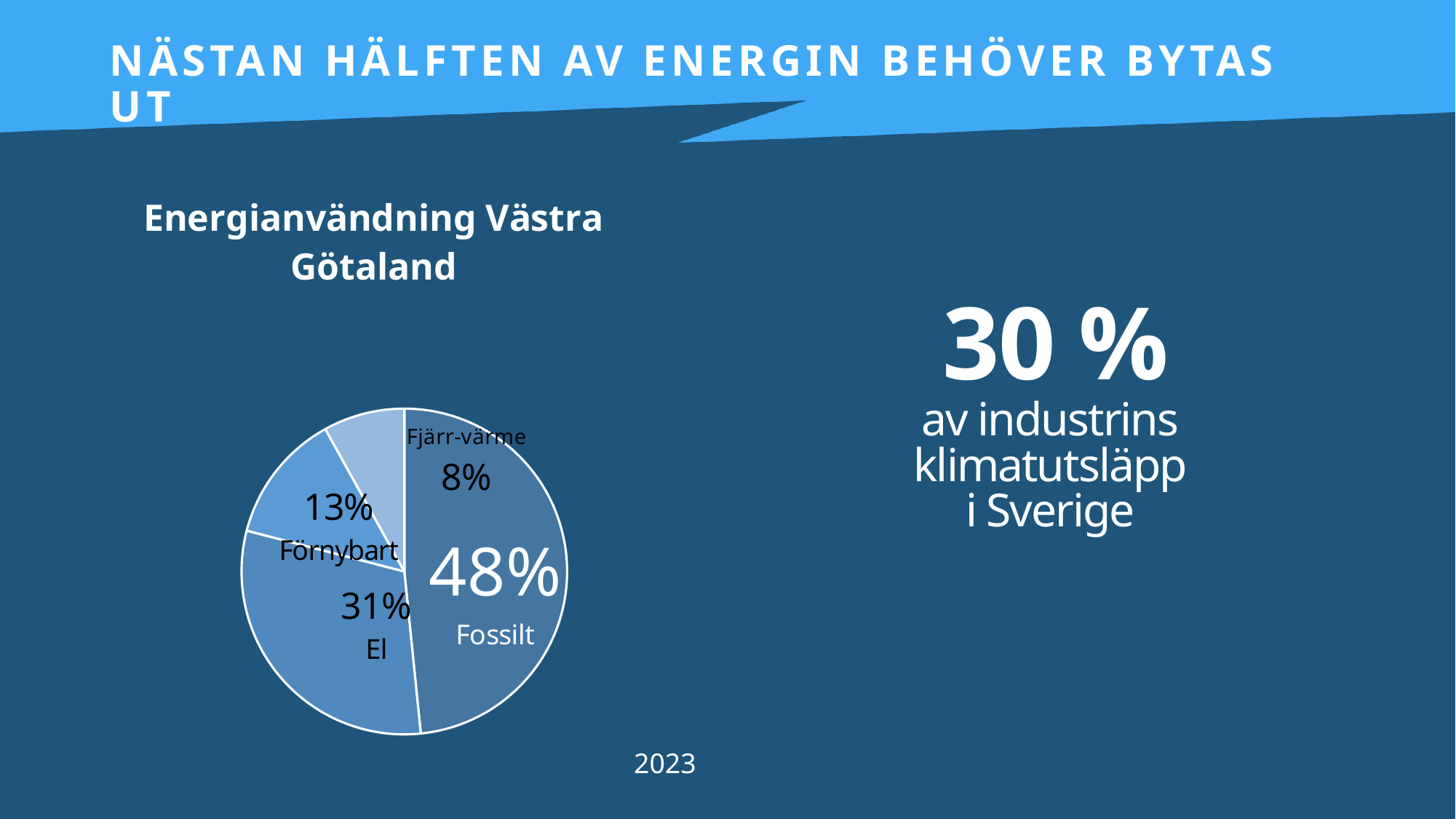
What year is shown below the chart? 2023 What kind of chart is shown on the slide? Pie chart Which is larger, the share for Förnybart or the share for Fjärr-värme? Förnybart Which category has the largest share of the pie? Fossilt What share of energy use in Västra Götaland is Fossilt? 48% How many slices does the pie chart have? 4 Which category has the smallest share of the pie? Fjärr-värme What share of energy use in Västra Götaland is Förnybart? 13% What is the title of the chart? Energianvändning Västra Götaland What share of energy use in Västra Götaland is El? 31% What is the difference in percentage points between Fossilt and El? 17 What share of energy use in Västra Götaland is Fjärr-värme? 8%